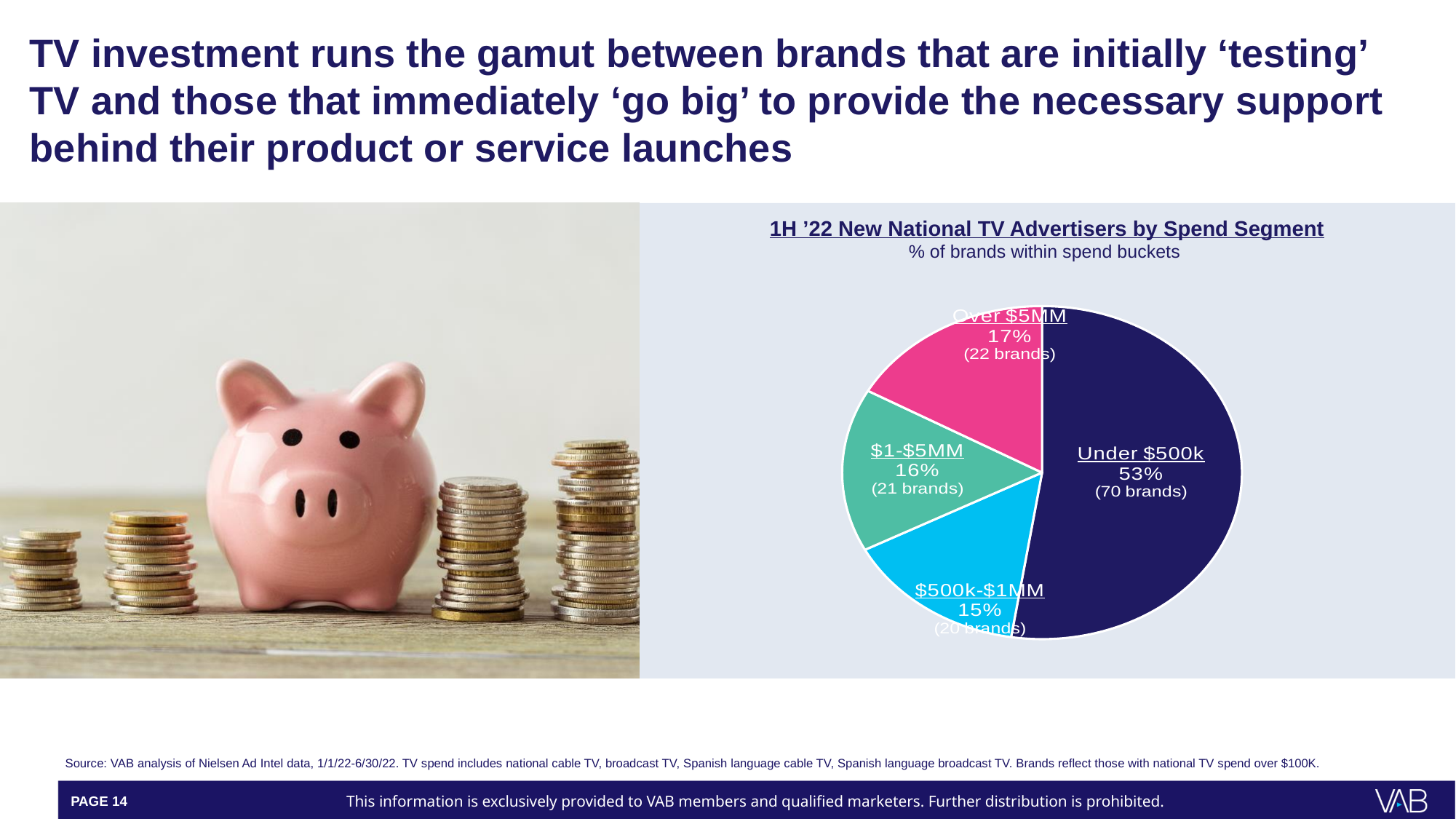
Which spend segment has the largest share of brands? Under $500k Which spend segment has the smallest share of brands? $500k-$1MM How many brands are in the $1-$5MM spend segment? 21 brands What percentage of brands fall in the Under $500k spend segment? 53% What type of chart is shown on the slide? Pie chart What percentage of brands are in the Over $5MM segment? 17% How many spend segments are shown in the pie chart? 4 What is the title of the chart? 1H '22 New National TV Advertisers by Spend Segment How many brands are in the $500k-$1MM segment? 20 brands What is the difference in percentage points between the Under $500k segment and the Over $5MM segment? 36 percentage points What is the total number of brands across all four spend segments? 133 brands Which segment has more brands, $1-$5MM or $500k-$1MM? $1-$5MM